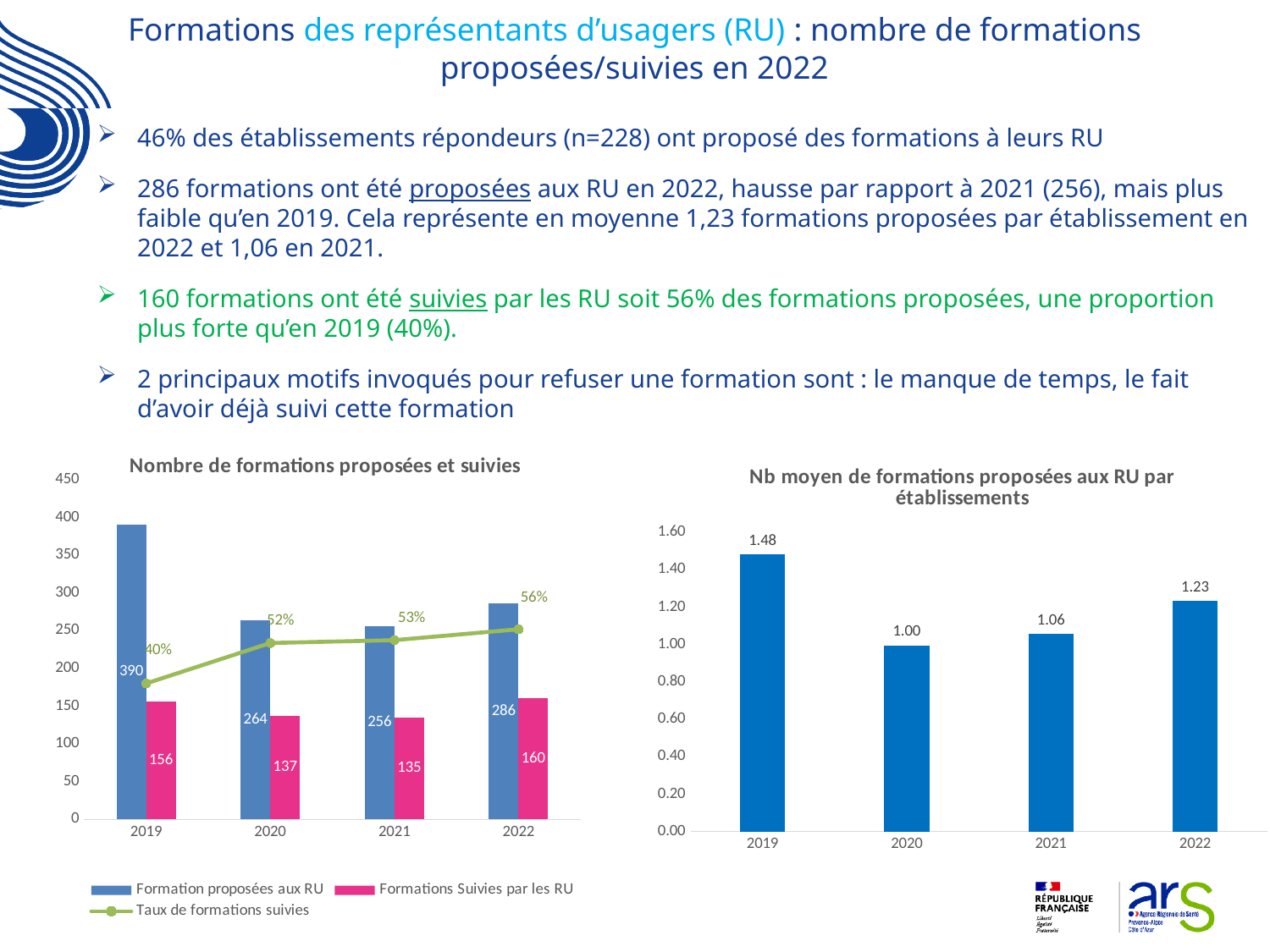
In the chart 'Nb moyen de formations proposées aux RU par établissements', which year has the lowest value? 2020 In the chart 'Nb moyen de formations proposées aux RU par établissements', what is the value for 2021? 1.06 In the chart 'Nombre de formations proposées et suivies', what is the difference between 'Formation proposées aux RU' in 2022 and in 2021? 30 In the chart 'Nb moyen de formations proposées aux RU par établissements', which year has the highest value? 2019 What kind of chart is 'Nb moyen de formations proposées aux RU par établissements'? bar chart How many series does the legend of the chart 'Nombre de formations proposées et suivies' list? 3 In the chart 'Nombre de formations proposées et suivies', does the 'Taux de formations suivies' rise or fall from 2019 to 2022? rise In the chart 'Nombre de formations proposées et suivies', which year has the lowest value for 'Formations Suivies par les RU'? 2021 In the chart 'Nb moyen de formations proposées aux RU par établissements', how many years are shown on the x axis? 4 In the chart 'Nombre de formations proposées et suivies', what is the 'Taux de formations suivies' for 2020? 52% In the chart 'Nombre de formations proposées et suivies', what is the value for 'Formations Suivies par les RU' in 2022? 160 In the chart 'Nombre de formations proposées et suivies', what is the value for 'Formation proposées aux RU' in 2019? 390